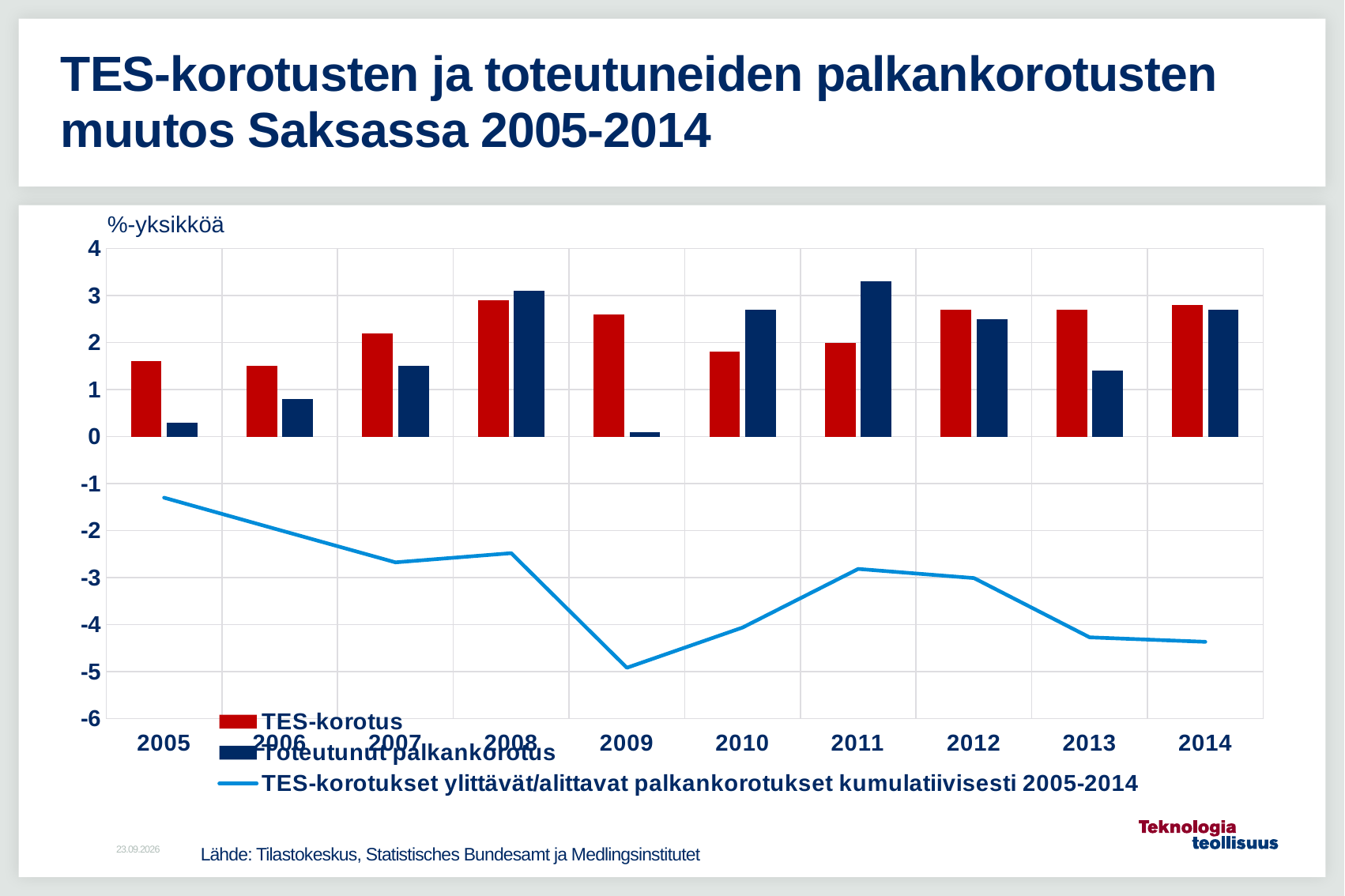
Which year has the lowest value for Toteutunut palkankorotus? 2009 Does the cumulative line rise or fall from 2011 to 2014? Falls How many series does the legend list? 3 Is the value for Toteutunut palkankorotus in 2009 greater or less than 1? less What kind of chart is shown on the slide? A combined bar and line chart In 2011, which is larger: TES-korotus or Toteutunut palkankorotus? Toteutunut palkankorotus Which year has the highest value for Toteutunut palkankorotus? 2011 How many years are shown on the x axis? 10 In which year does the line 'TES-korotukset ylittävät/alittavat palkankorotukset kumulatiivisesti 2005-2014' reach its lowest point? 2009 Is the value for TES-korotus in 2008 greater or less than 2? greater Is the value of the cumulative line in 2009 greater or less than -4? less In 2013, which is larger: TES-korotus or Toteutunut palkankorotus? TES-korotus